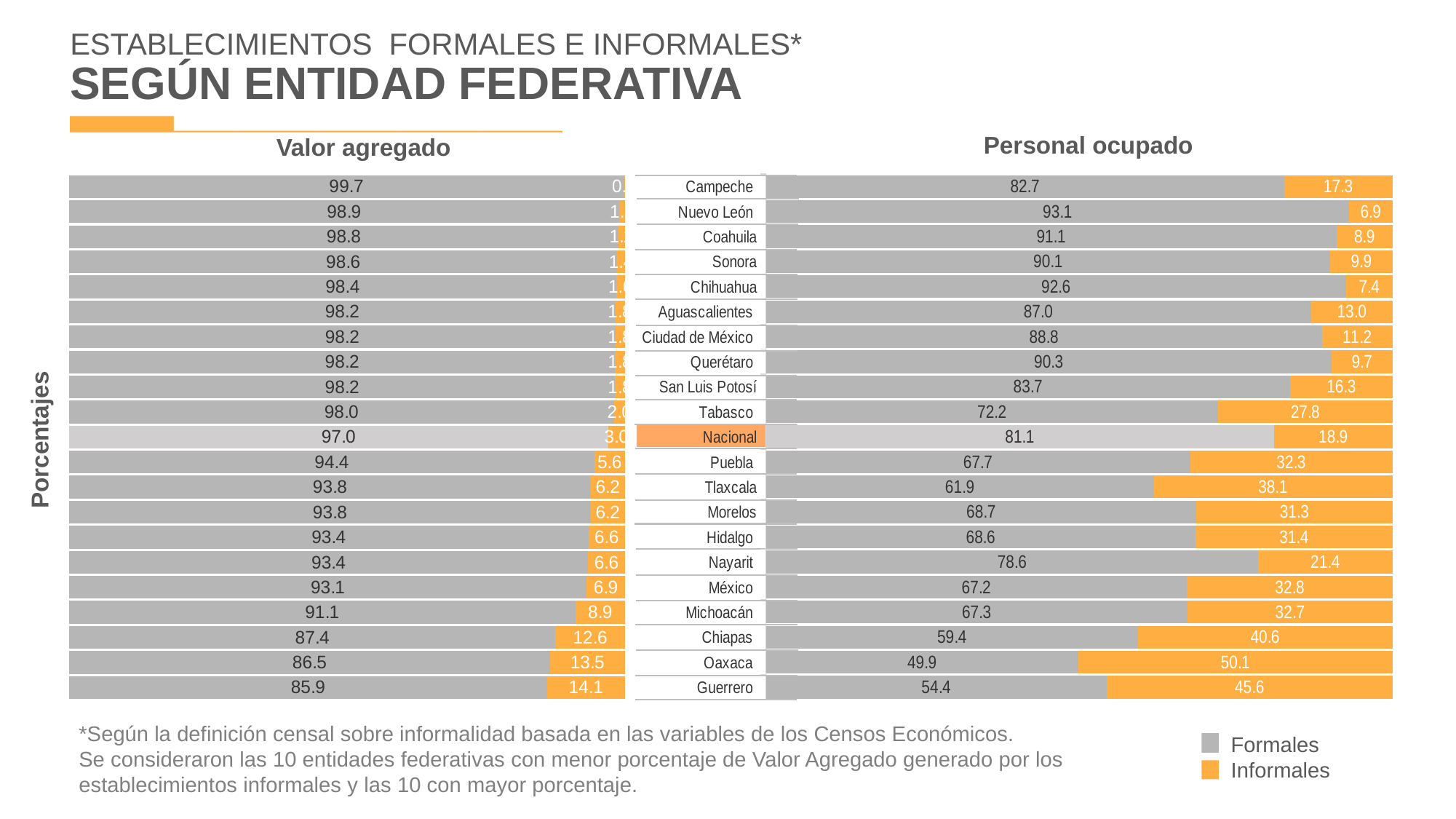
How many entities (rows) are shown in the Valor agregado chart? 21 In the Personal ocupado chart, what is the difference between the Informales values for Chiapas and Guerrero? 5.0 In the Personal ocupado chart, which entity has the highest Formales value? Nuevo León In the Personal ocupado chart, what is the Formales value for Nacional? 81.1 Which colour represents Informales in the legend? Orange How many series does the legend list? 2 In the Valor agregado chart, what is the Informales value for Guerrero? 14.1 In the Personal ocupado chart, what is the Informales value for Oaxaca? 50.1 In the Valor agregado chart, which entity has the lowest Formales value? Guerrero What kind of chart is the Personal ocupado chart? Stacked bar chart In the Personal ocupado chart, which is larger, the Formales value for Tabasco or for Nayarit? Nayarit In the Valor agregado chart, what is the Formales value for Campeche? 99.7